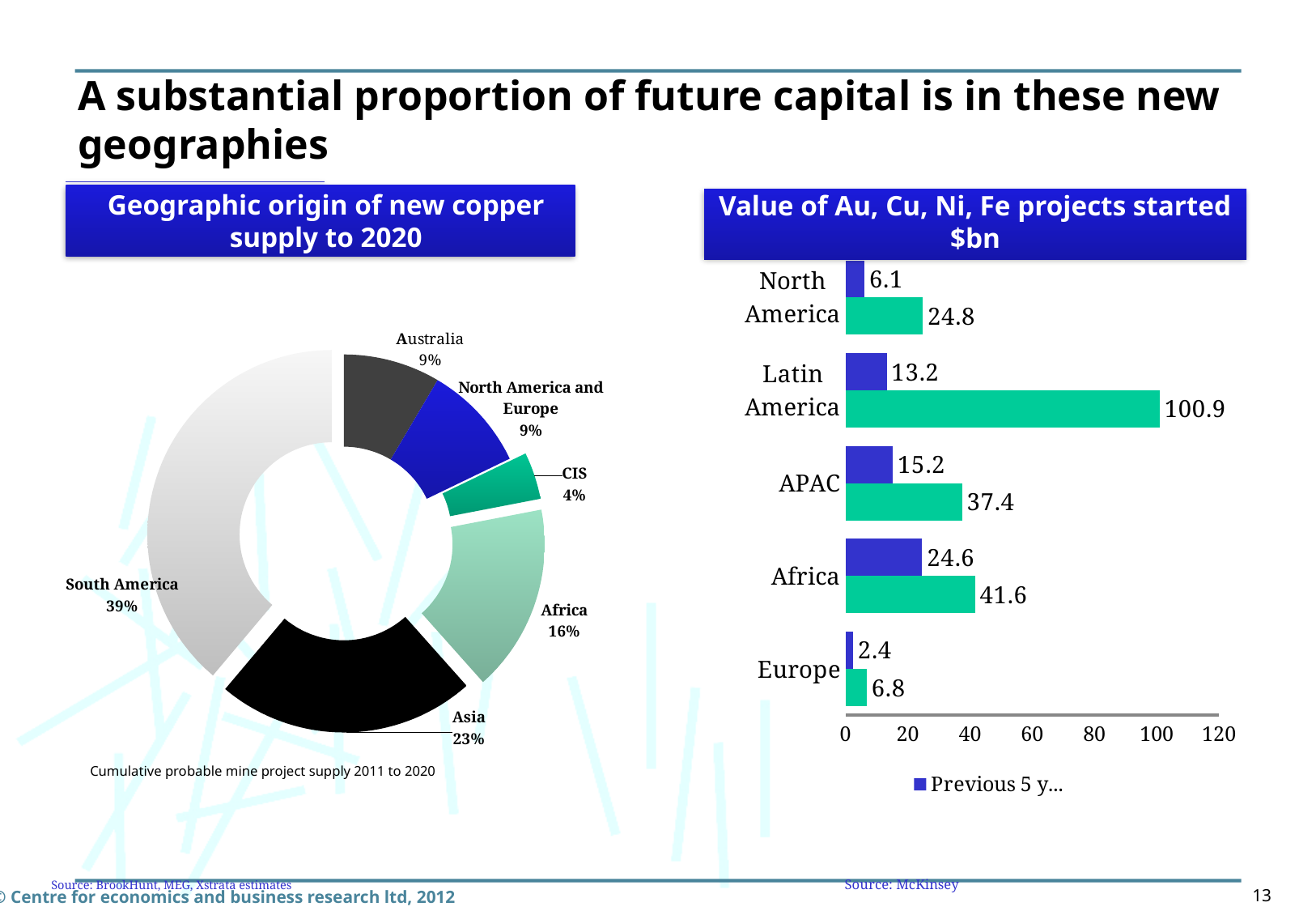
In the 'Geographic origin of new copper supply to 2020' chart, which region has the smallest share? CIS What kind of chart is the 'Value of Au, Cu, Ni, Fe projects started $bn' chart? Bar chart In the 'Geographic origin of new copper supply to 2020' chart, which region has the largest share? South America In the 'Geographic origin of new copper supply to 2020' chart, how many regions are shown? 6 In the 'Geographic origin of new copper supply to 2020' chart, what share does South America have? 39% In the 'Value of Au, Cu, Ni, Fe projects started $bn' chart, what is the value of the blue 'Previous 5 y...' bar for Africa? 24.6 In the 'Geographic origin of new copper supply to 2020' chart, what is the difference in percentage points between Asia and Africa? 7 What kind of chart is the 'Geographic origin of new copper supply to 2020' chart? Doughnut chart In the 'Value of Au, Cu, Ni, Fe projects started $bn' chart, what is the value of the green bar for Latin America? 100.9 In the 'Value of Au, Cu, Ni, Fe projects started $bn' chart, what is the difference between the green bar and the blue bar for APAC? 22.2 In the 'Value of Au, Cu, Ni, Fe projects started $bn' chart, which region has the highest green bar value? Latin America In the 'Value of Au, Cu, Ni, Fe projects started $bn' chart, which region has the lowest blue 'Previous 5 y...' bar value? Europe